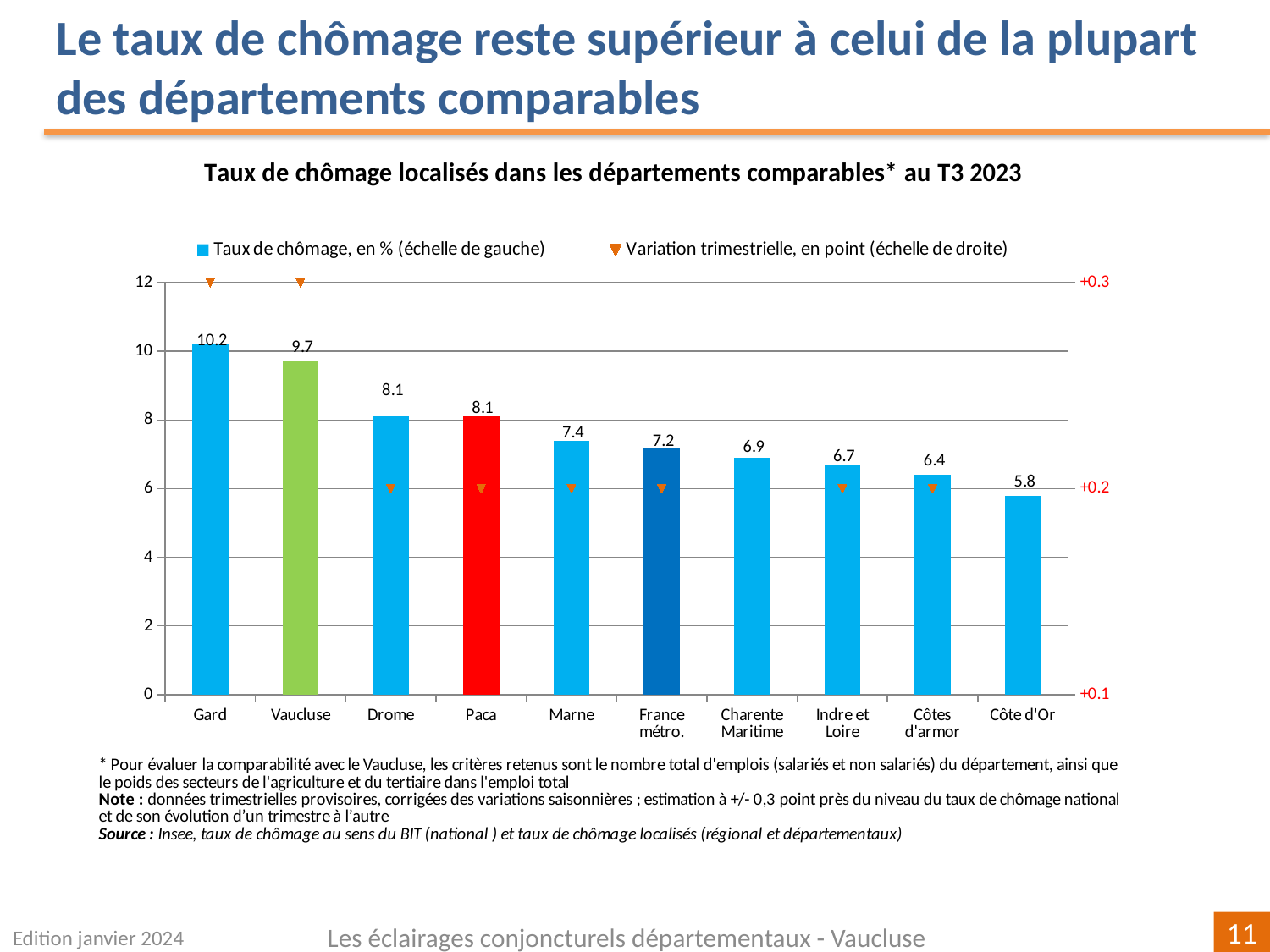
What is the quarterly variation (right axis) shown for Vaucluse? +0.3 What is the difference between the unemployment rates of Vaucluse and France métro.? 2.5 What is the quarterly variation (right axis) shown for Drome? +0.2 What is the unemployment rate shown for Gard? 10.2 Which category has the lowest unemployment rate on the chart? Côte d'Or What is the unemployment rate shown for France métro.? 7.2 Which department has the highest unemployment rate on the chart? Gard Which has a higher unemployment rate, Marne or Charente Maritime? Marne How many categories are shown on the x axis? 10 How many series does the legend list? 2 What is the unemployment rate shown for Vaucluse? 9.7 What kind of chart is this? Bar chart